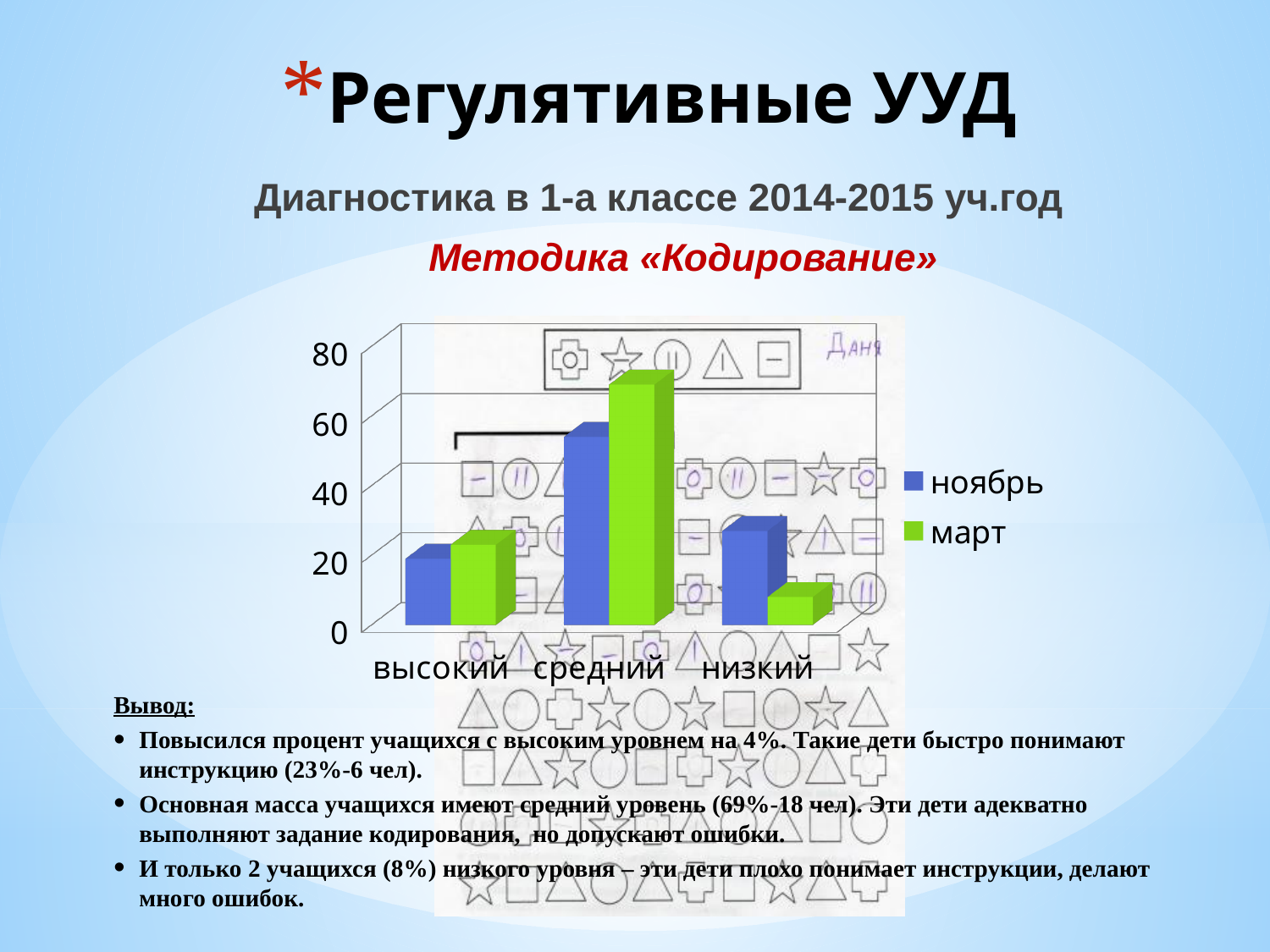
How many series does the chart legend list? 2 For the category средний, which series has the larger value, ноябрь or март? март Which category has the highest value for ноябрь? средний Which category has the highest value for март? средний How many categories are shown on the x axis of the chart? 3 Which category has the lowest value for ноябрь? высокий For the category низкий, which series has the larger value, ноябрь or март? ноябрь Which series is shown in green in the chart? март What kind of chart is shown on the slide? bar chart Is the value for март in the category средний greater or less than 60? greater Is the value for март in the category низкий greater or less than 20? less Which category has the lowest value for март? низкий